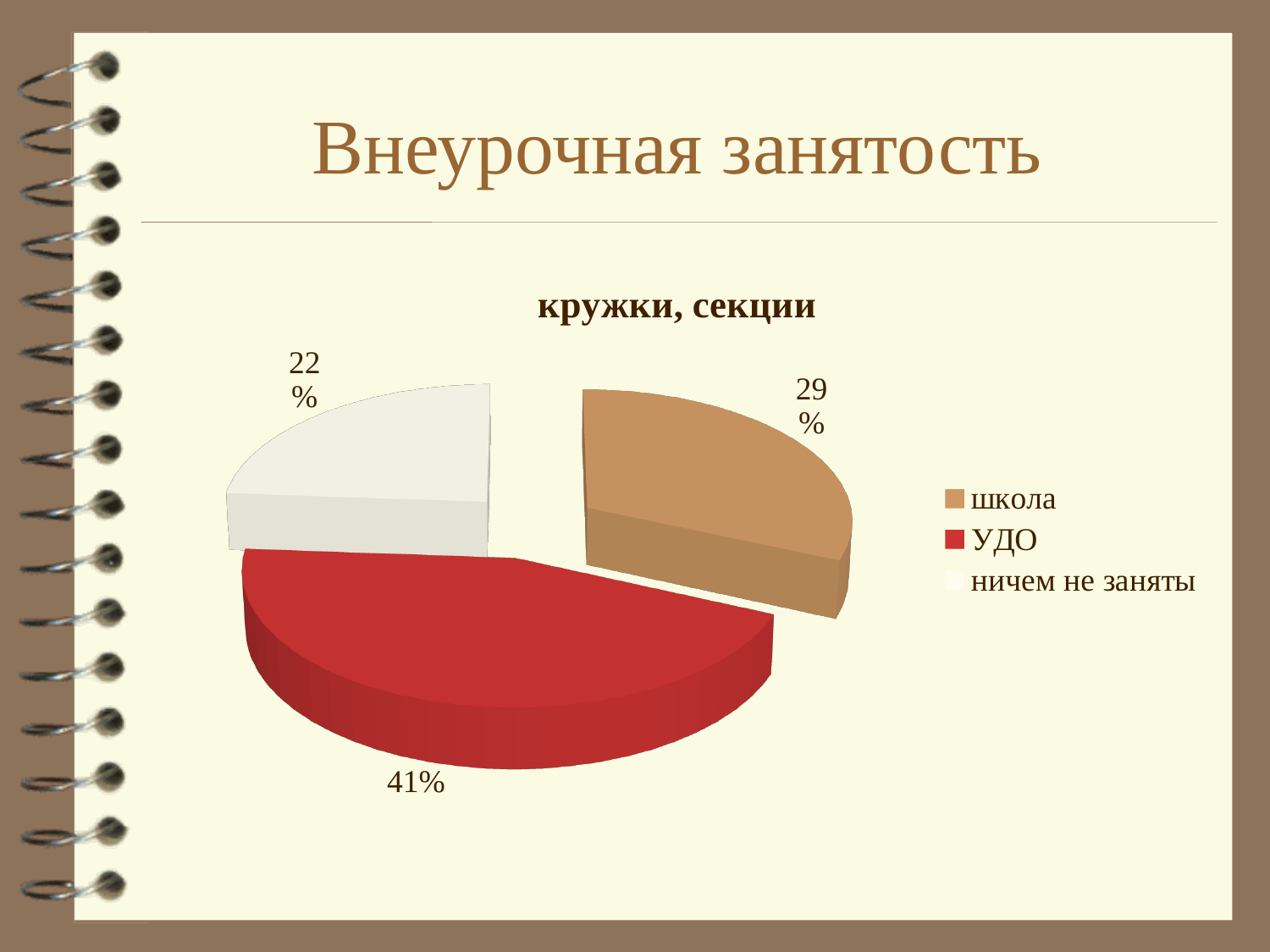
Which category has the smallest slice of the pie? ничем не заняты What percentage of the pie is labelled for УДО? 41% What is the title of the chart? кружки, секции Which slice is larger, школа or ничем не заняты? школа How many entries does the legend list? 3 What is the difference in percentage points between the УДО slice and the школа slice? 12 Which category has the largest slice of the pie? УДО What percentage of the pie is labelled for ничем не заняты? 22% What percentage of the pie is labelled for школа? 29% How many slices does the pie chart have? 3 What is the difference in percentage points between the школа slice and the ничем не заняты slice? 7 What kind of chart is shown on the slide? pie chart